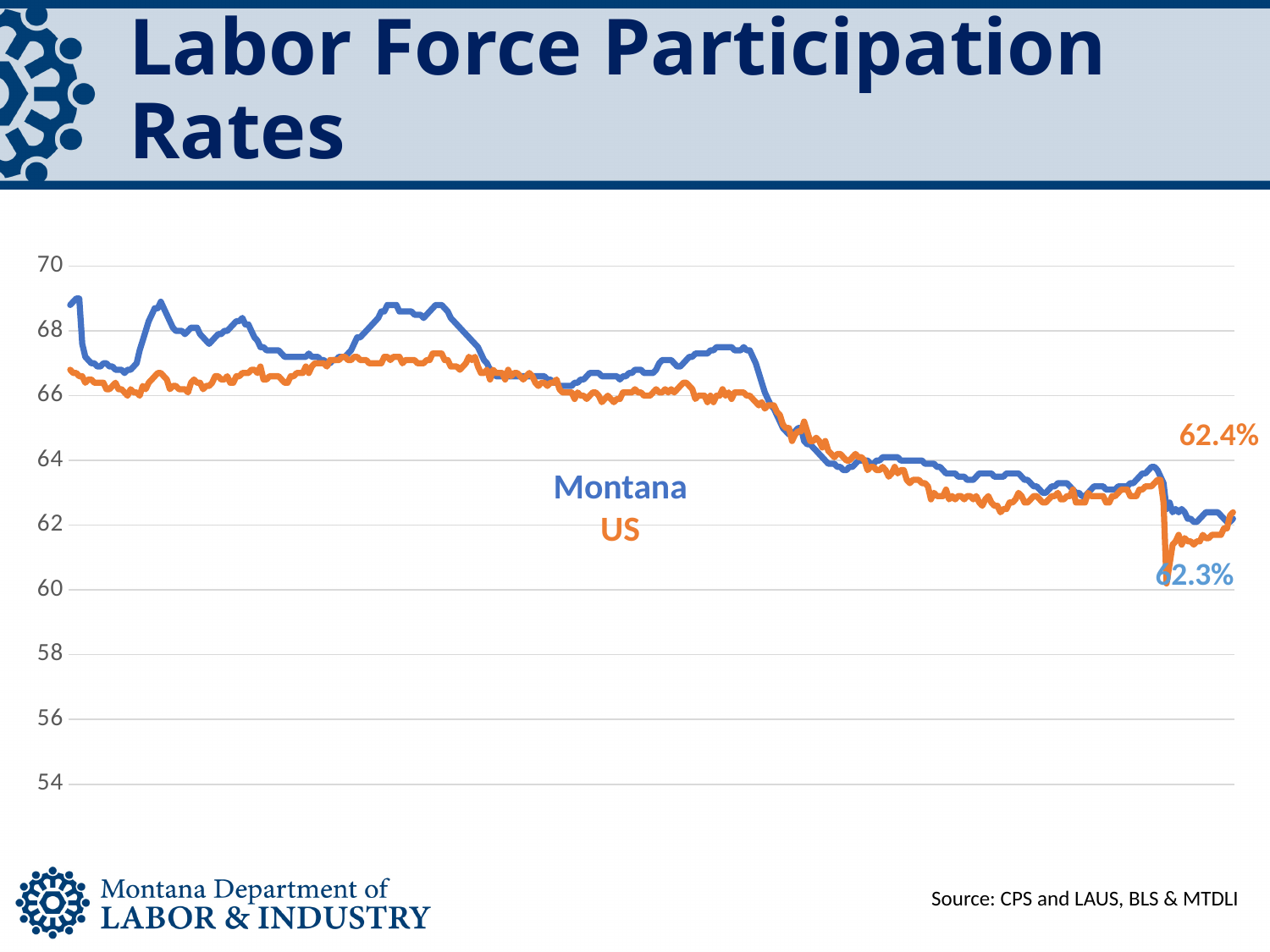
Which colour is used for the Montana line? Blue What is the latest labor force participation rate shown for the US? 62.4% Is the highest value reached by the Montana line greater or less than 68? greater Based on the labelled end values, which is higher: the latest US rate or the latest Montana rate? US Is the lowest value reached by the US line greater or less than 62? less Over the whole period shown, do the labor force participation rates generally rise or fall? Fall Is the highest value reached by the US line greater or less than 68? less What kind of chart is shown on the slide? Line chart What is the difference between the latest US rate (62.4%) and the latest Montana rate (62.3%)? 0.1 percentage points What is the latest labor force participation rate shown for Montana? 62.3% What is the title of the slide containing the chart? Labor Force Participation Rates How many series are plotted on the chart? 2